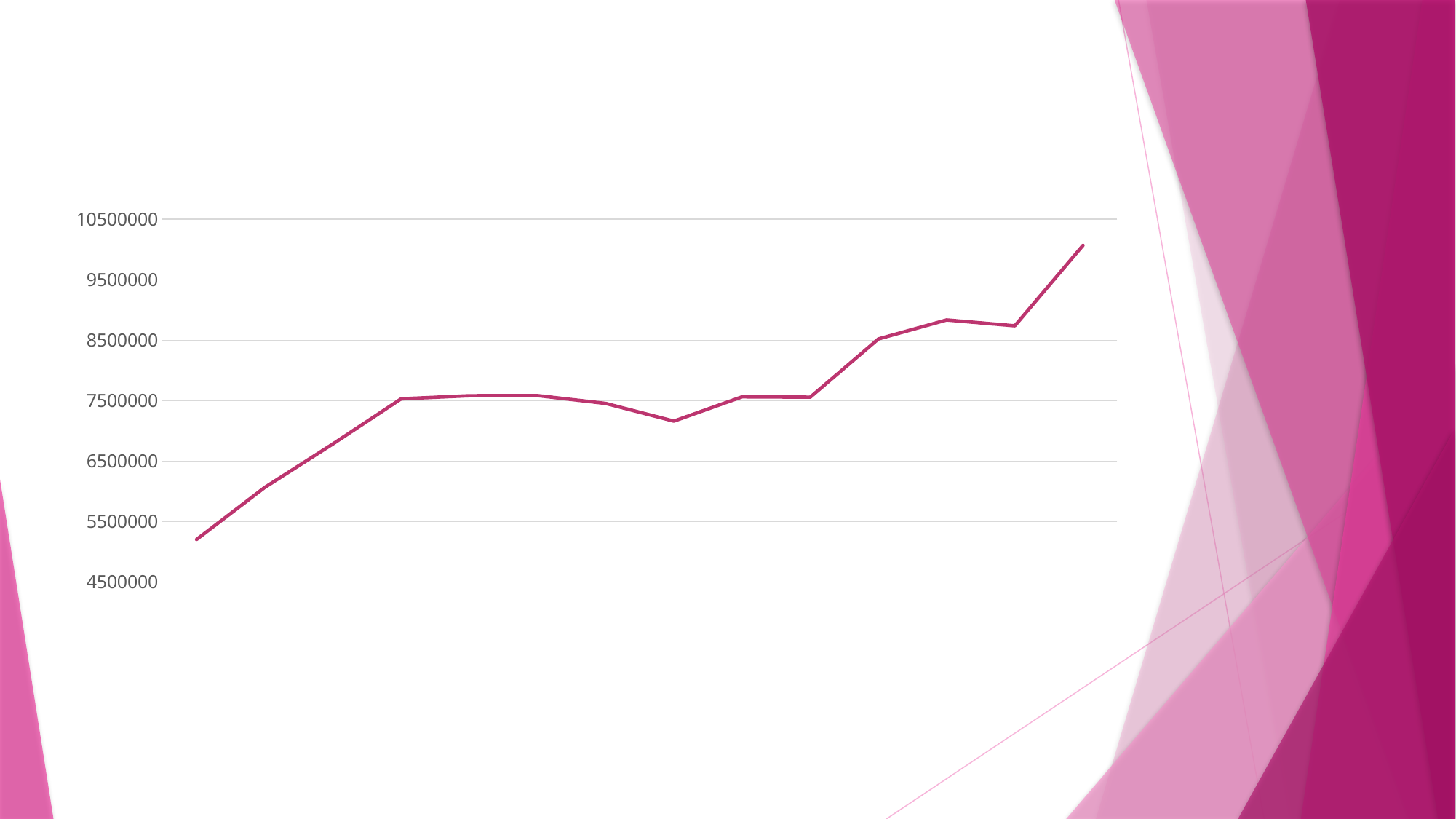
Which point has the highest value, the first or the last? the last Is the value of the last (rightmost) point greater or less than 9500000? greater How many data points are plotted on the line? 14 Is the value of the second point greater or less than 6500000? less Overall, do the values rise or fall from left to right along the x axis? rise What is the lowest value shown on the vertical axis? 4500000 Is the value of the first (leftmost) point greater or less than 5500000? less Which point on the line has the highest value? the last (rightmost) point How many lines (series) are plotted on the chart? 1 Which point on the line has the lowest value? the first (leftmost) point What kind of chart is shown on the slide? line chart What is the highest value shown on the vertical axis? 10500000